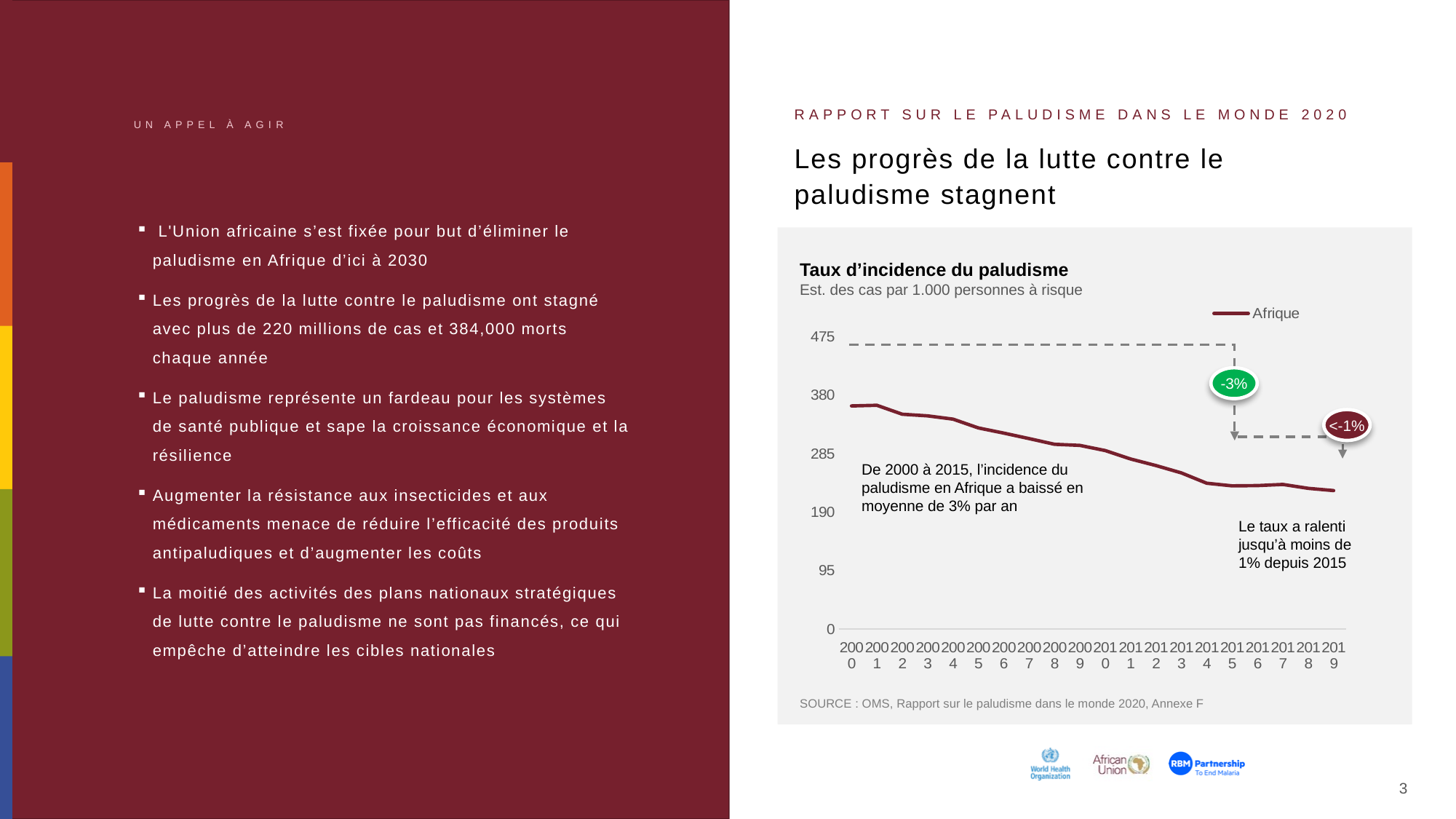
What kind of chart is shown on the slide? line chart Is the value for 2000 greater or less than 285? greater How many years are plotted along the x axis of the chart? 20 Is the value for 2010 greater or less than 380? less What is the title of the chart? Taux d’incidence du paludisme Which year has the larger value, 2000 or 2019? 2000 Is the value for 2019 greater or less than 190? greater Do the values in the chart rise or fall from 2000 to 2019? fall How many series does the chart legend list? 1 What is the name of the series shown in the chart legend? Afrique